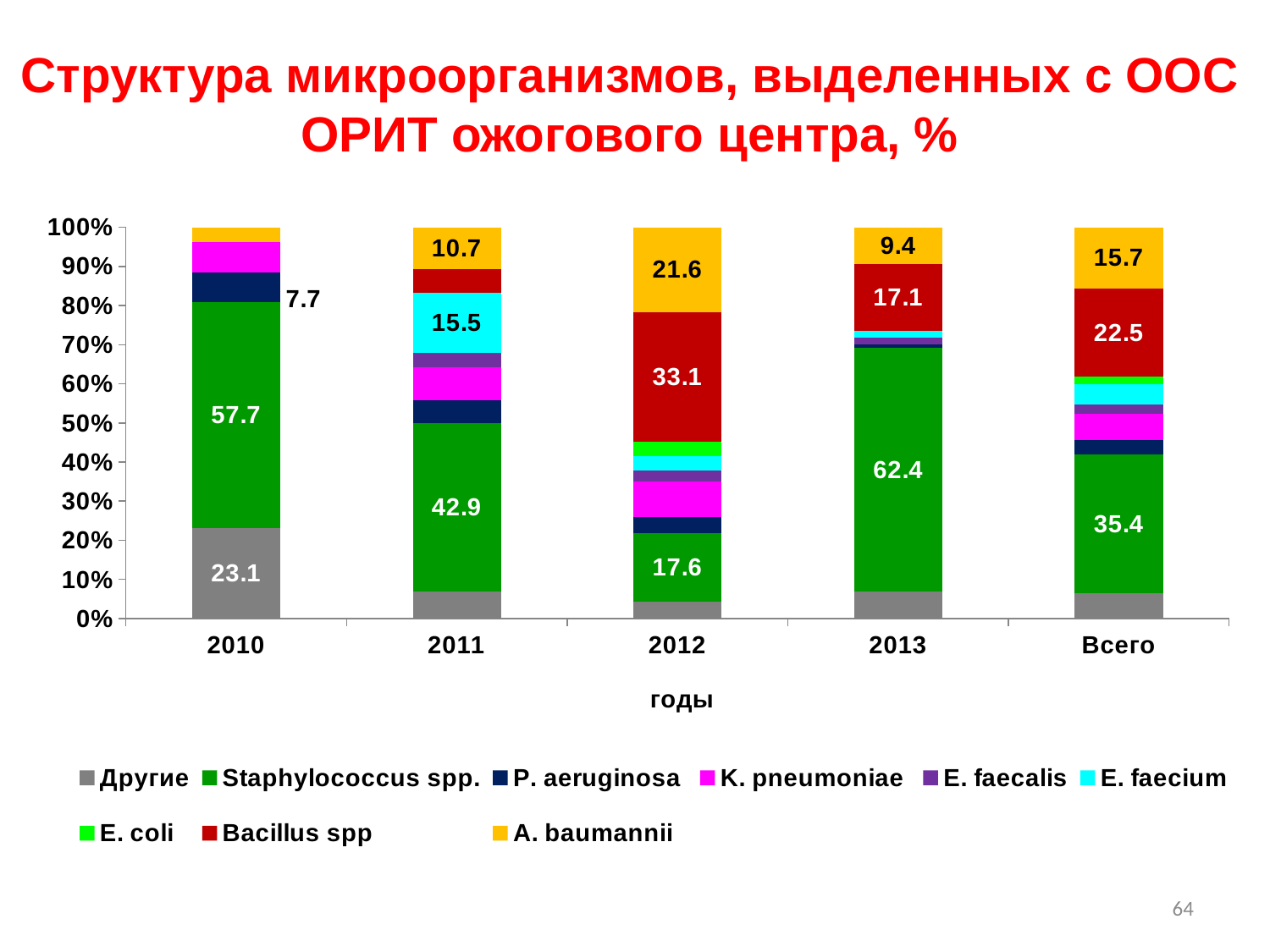
In which year is the share of Staphylococcus spp. the lowest? 2012 What is the difference between the Staphylococcus spp. values for 2013 and 2012? 44.8 What is the value for Staphylococcus spp. in 2010? 57.7 In which year is the share of Staphylococcus spp. the highest? 2013 What is the value for Bacillus spp in 2012? 33.1 What is the value for E. faecium in 2011? 15.5 Which year has the larger A. baumannii value, 2012 or 2013? 2012 What is the value for Другие in 2010? 23.1 What kind of chart is shown on the slide? Stacked bar chart How many categories are shown on the x axis? 5 What is the value for A. baumannii in 2011? 10.7 How many series does the legend list? 9